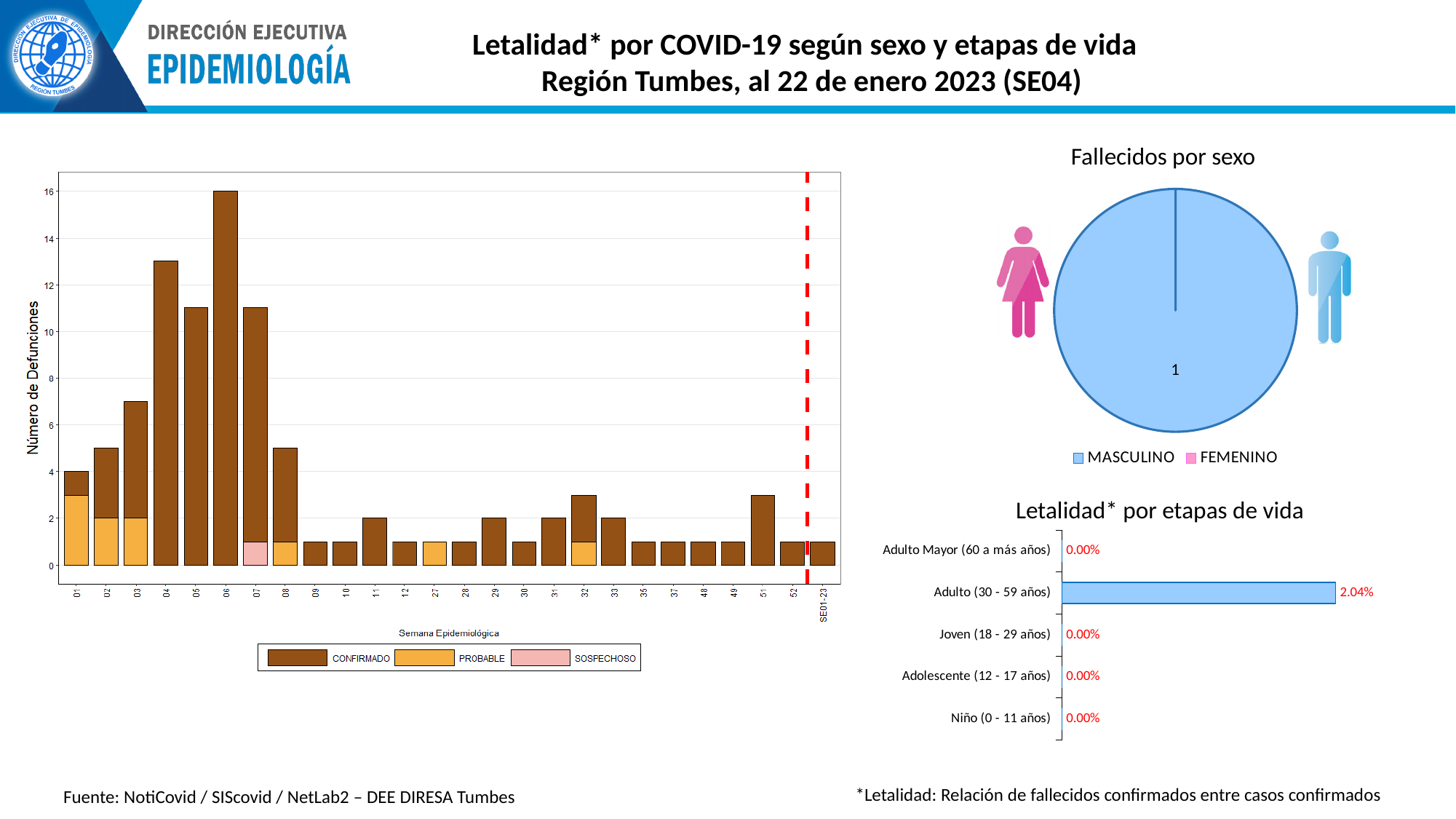
In the 'Fallecidos por sexo' pie chart, how many entries does the legend list? 2 In the bar chart on the left, which epidemiological week has the highest number of deaths? 06 In the 'Letalidad* por etapas de vida' chart, what is the value for Adulto (30 - 59 años)? 2.04% In the 'Fallecidos por sexo' chart, what value is printed on the MASCULINO slice? 1 In the bar chart on the left, what is the total number of deaths for week 06? 16 What kind of chart is 'Fallecidos por sexo'? Pie chart How many series does the legend of the 'Número de Defunciones' bar chart on the left list? 3 How many age-group categories are shown in the 'Letalidad* por etapas de vida' chart? 5 In the bar chart on the left, is the total for week 04 greater or less than 12? greater In the bar chart on the left, which week has more deaths, 05 or 08? 05 In the 'Letalidad* por etapas de vida' chart, what is the value for Niño (0 - 11 años)? 0.00% In the 'Letalidad* por etapas de vida' chart, which age group has the highest lethality? Adulto (30 - 59 años)